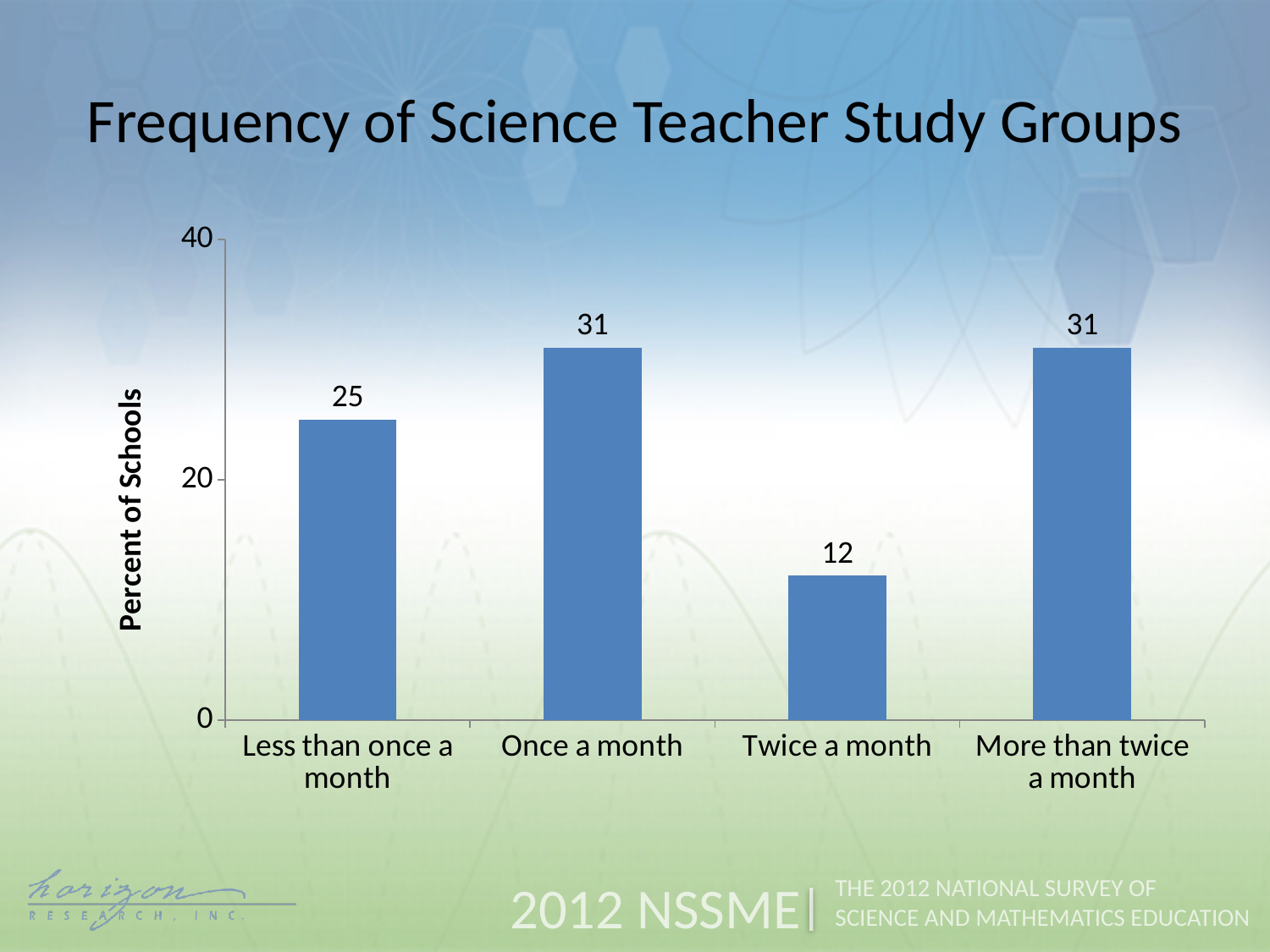
Which category has the lowest value? Twice a month What kind of chart is shown on the slide? bar chart What is the value for "Twice a month"? 12 How many categories are shown on the x axis? 4 What is the value for "Once a month"? 31 Which is larger, the value for "Less than once a month" or the value for "Once a month"? Once a month What is the difference between the values for "Less than once a month" and "Twice a month"? 13 What is the label of the y axis? Percent of Schools What is the difference between the values for "Once a month" and "Twice a month"? 19 Is the value for "Twice a month" greater or less than 20? less What is the value for "Less than once a month"? 25 What is the value for "More than twice a month"? 31